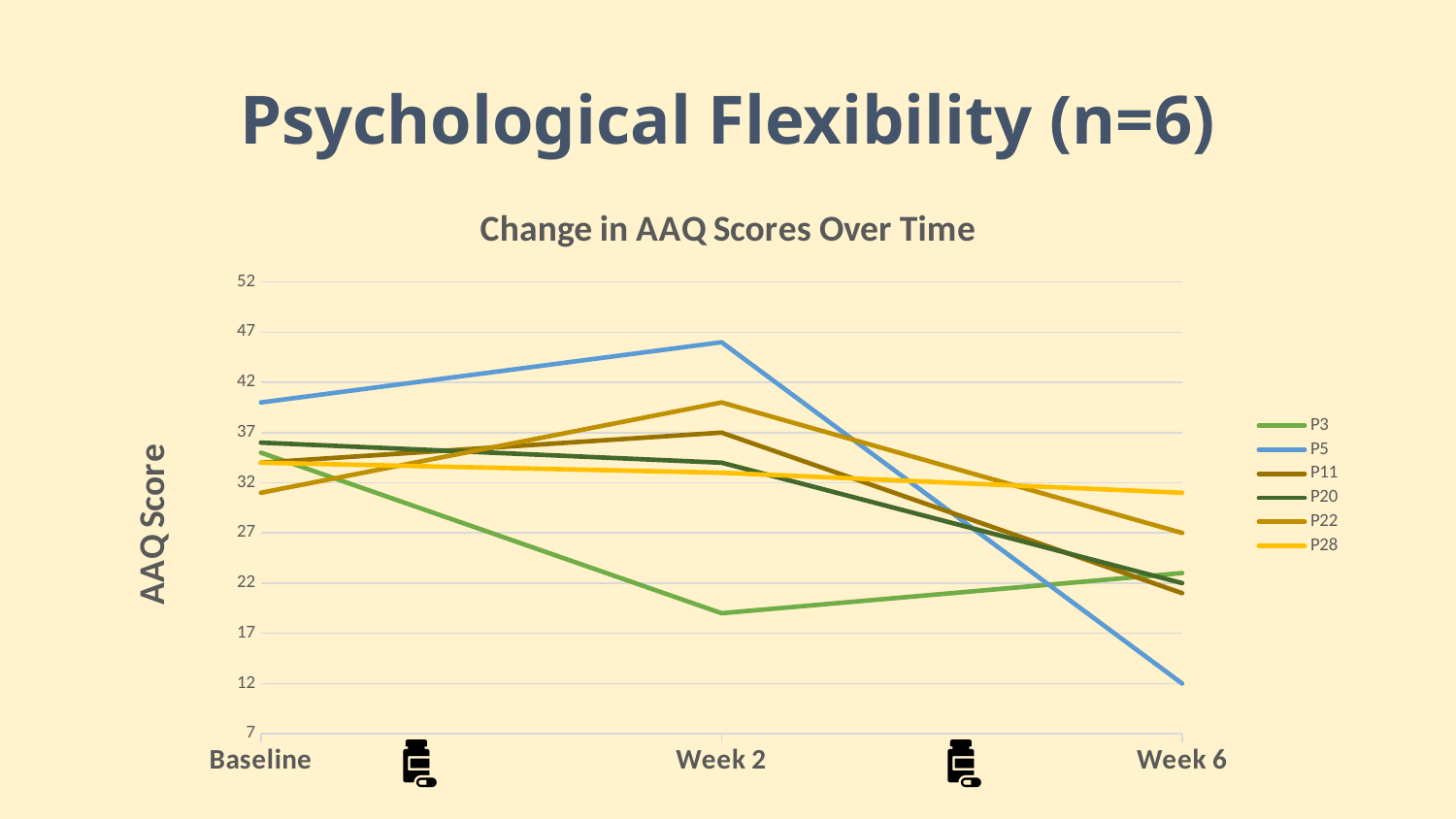
What is the AAQ score for P5 at Week 6? 12 How many time points are shown on the x axis? 3 Is the AAQ score for P3 at Week 2 greater or less than 22? less Which participant has the highest AAQ score at Week 2? P5 What is the AAQ score for P11 at Week 2? 37 What is the AAQ score for P22 at Week 6? 27 What kind of chart is shown on the slide? line chart Which participant has the lowest AAQ score at Week 6? P5 How many series does the legend list? 6 At Week 6, which is higher: P22 or P28? P28 Does the AAQ score for P5 rise or fall from Week 2 to Week 6? fall Is the AAQ score for P5 at Week 2 greater or less than 42? greater